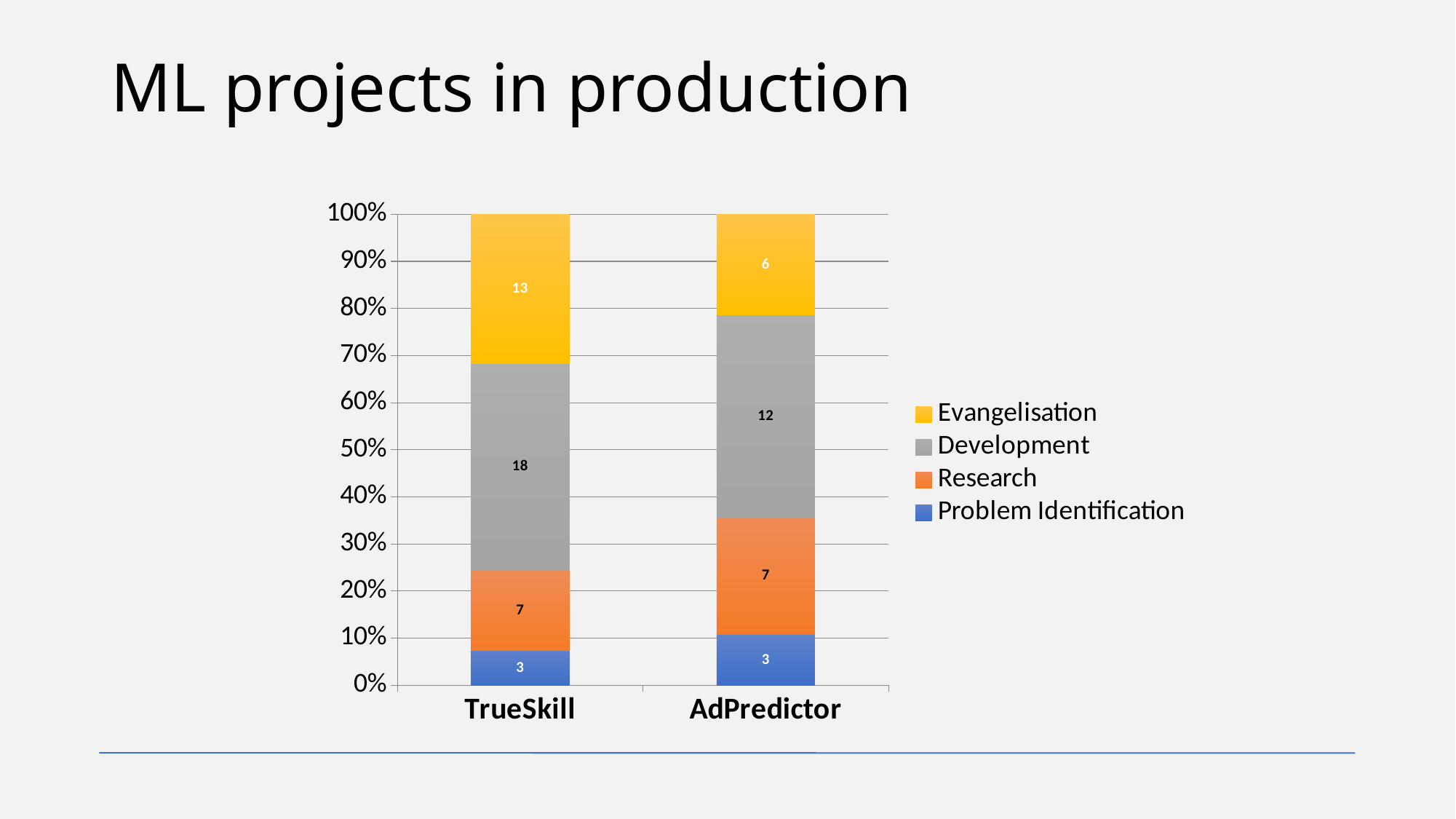
Which series has the highest value in the TrueSkill bar? Development What is the Evangelisation value for AdPredictor? 6 How many series does the legend list? 4 What is the Research value for TrueSkill? 7 Which series has the lowest value in the AdPredictor bar? Problem Identification Which has a larger Development value, TrueSkill or AdPredictor? TrueSkill What kind of chart is shown on the slide? Stacked bar chart What is the total of the data labels in the AdPredictor bar? 28 What is the Development value for TrueSkill? 18 What is the difference between the Evangelisation values for TrueSkill and AdPredictor? 7 What is the total of the data labels in the TrueSkill bar? 41 What is the Problem Identification value for AdPredictor? 3